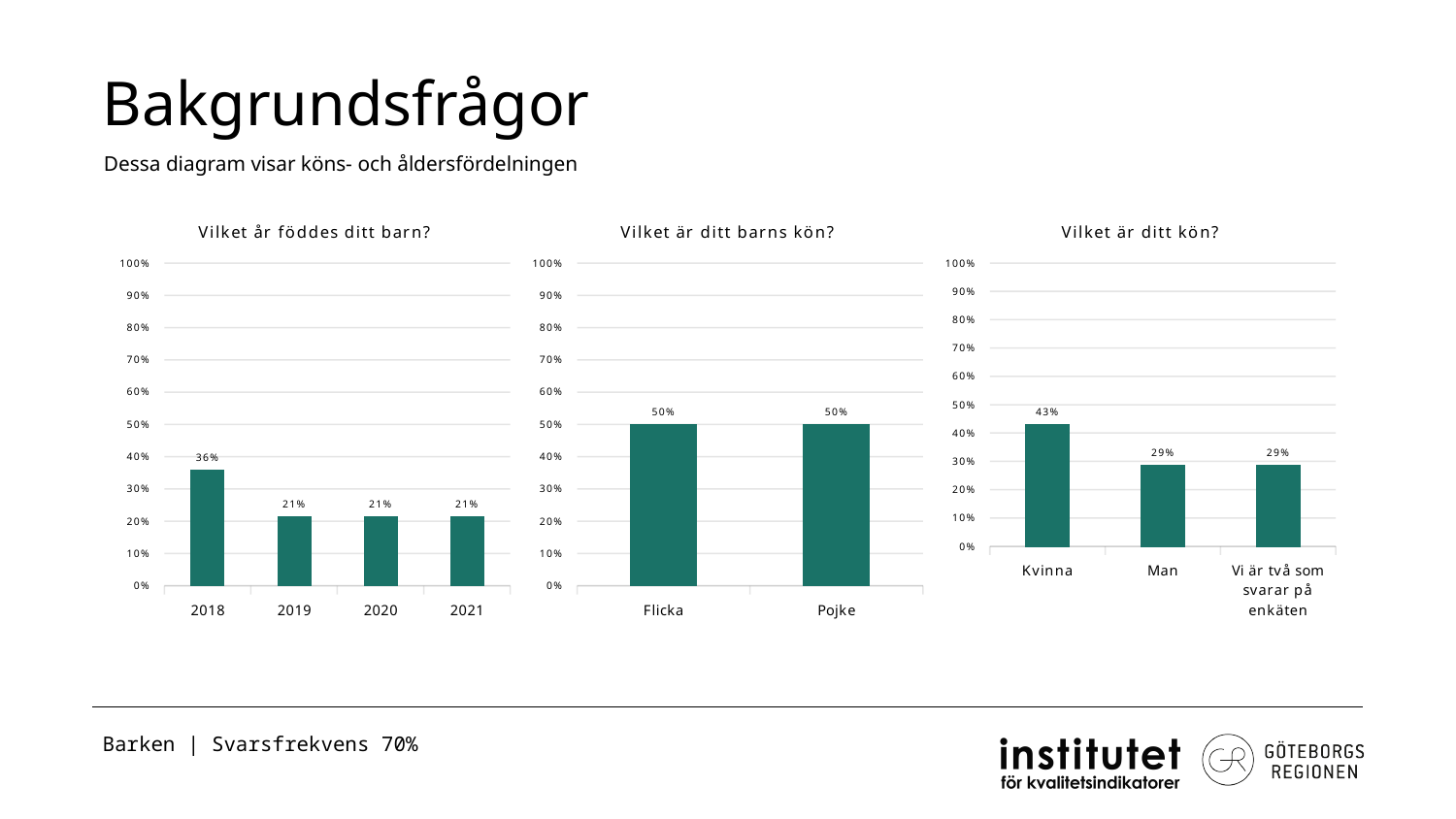
In the chart 'Vilket är ditt kön?', is the value for Kvinna greater or less than 40%? greater In the chart 'Vilket är ditt kön?', what is the difference between the values for Kvinna and Man? 14% In the chart 'Vilket år föddes ditt barn?', which year has the highest value? 2018 In the chart 'Vilket är ditt barns kön?', what is the total of the values for Flicka and Pojke? 100% In the chart 'Vilket år föddes ditt barn?', how many categories are shown on the x axis? 4 How many charts are shown on the slide? 3 In the chart 'Vilket är ditt kön?', which category has the highest value? Kvinna In the chart 'Vilket år föddes ditt barn?', what is the difference between the values for 2018 and 2019? 15% What kind of chart is 'Vilket är ditt barns kön?'? Bar chart In the chart 'Vilket är ditt barns kön?', what is the value for Pojke? 50% In the chart 'Vilket är ditt kön?', what is the value for Kvinna? 43% In the chart 'Vilket år föddes ditt barn?', what is the value for 2018? 36%